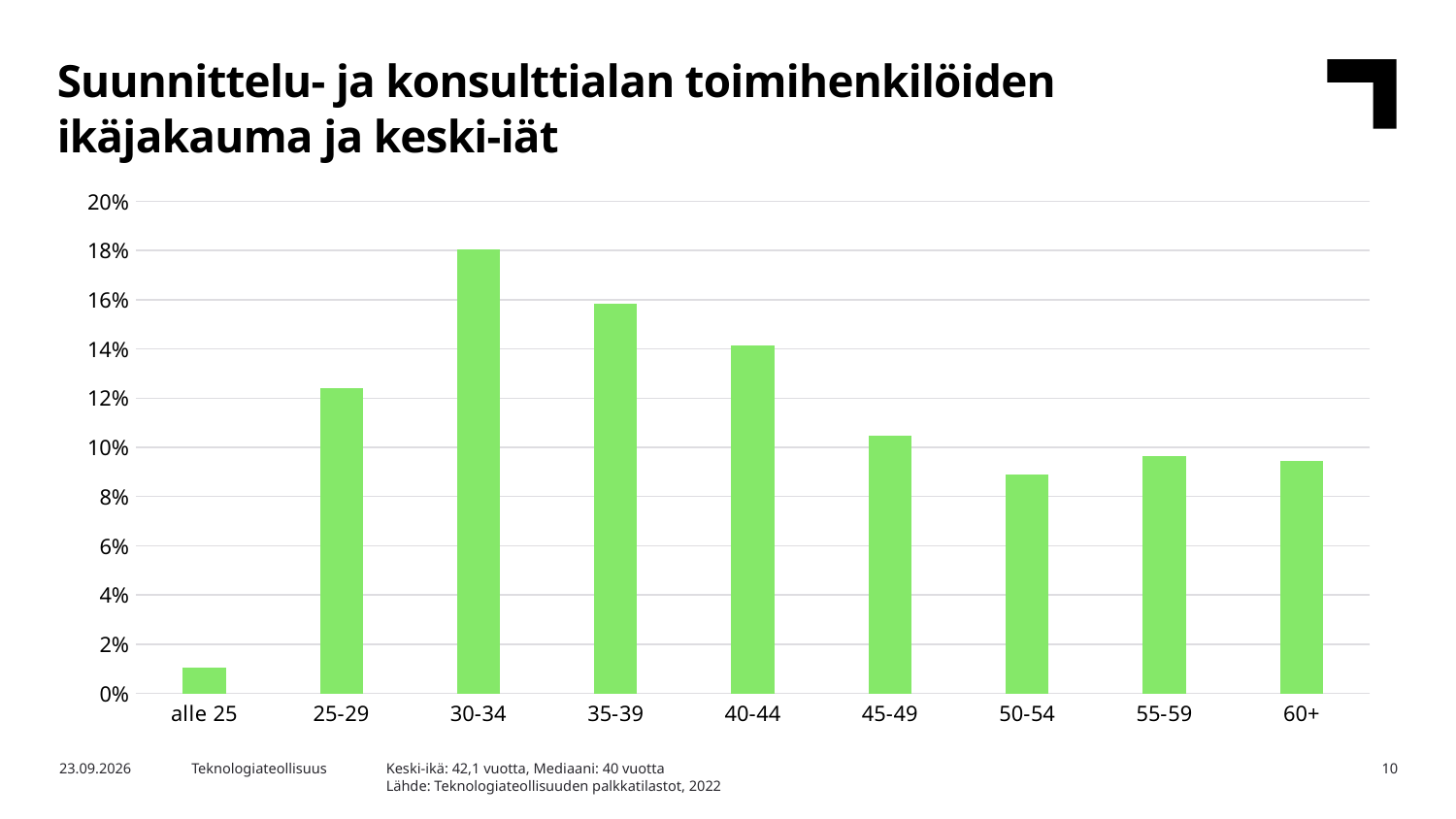
Is the value for alle 25 greater or less than 2%? less Which age group has the lowest share in the chart? alle 25 Which age group has the highest share in the chart? 30-34 What kind of chart is shown on the slide? bar chart Which is larger, the value for 35-39 or the value for 40-44? 35-39 Do the values rise or fall from 30-34 to 50-54? fall Which is larger, the value for 25-29 or the value for 45-49? 25-29 Is the value for 50-54 greater or less than 10%? less Is the value for 25-29 greater or less than 12%? greater How many age groups are shown on the x axis? 9